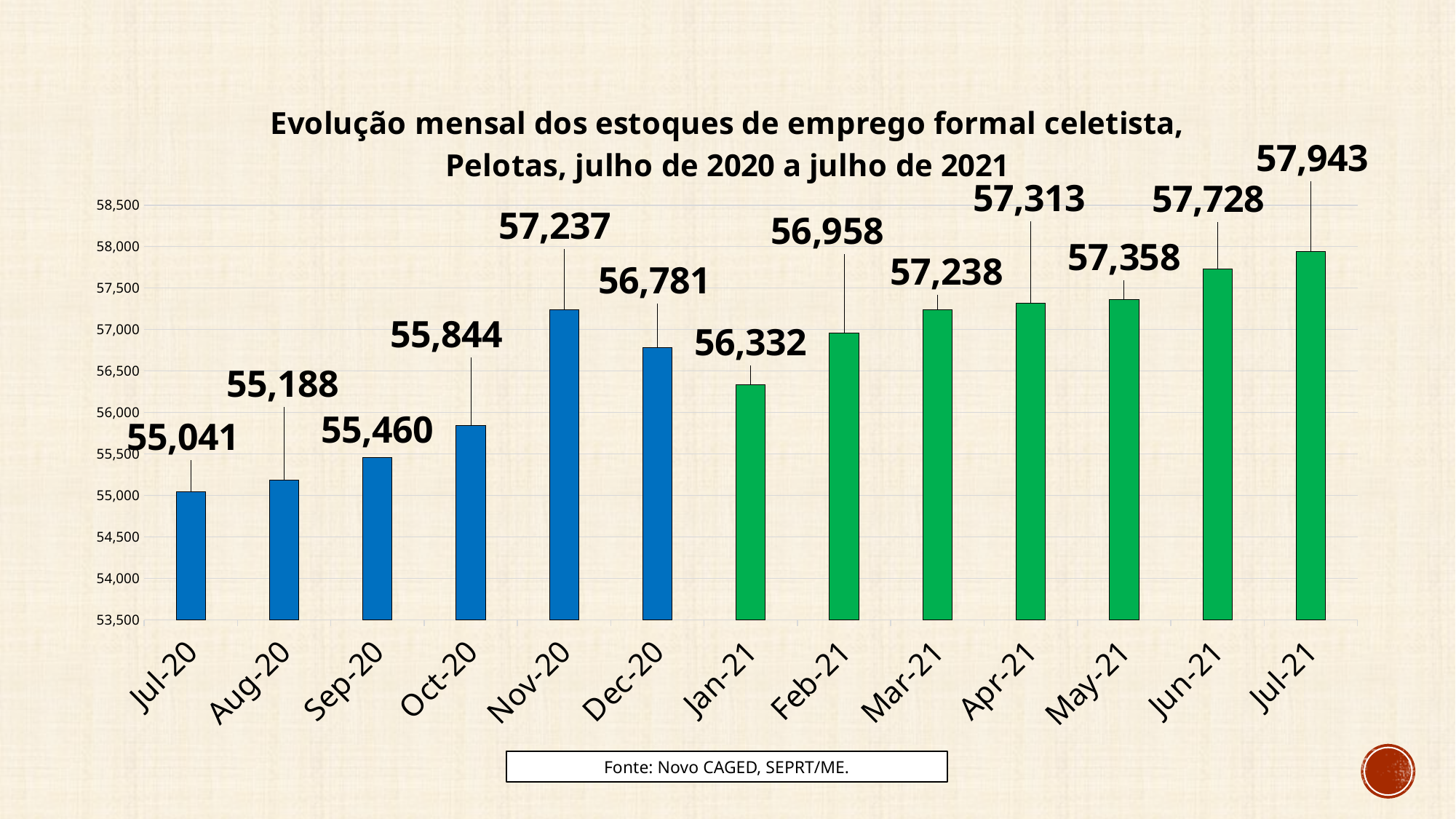
What source is cited below the chart? Novo CAGED, SEPRT/ME. Which month has the highest value? Jul-21 What is the value for Dec-20? 56,781 What is the difference between the values for Nov-20 and Dec-20? 456 Which month has the lowest value? Jul-20 Which is larger, the value for Feb-21 or the value for Dec-20? Feb-21 How many months are shown on the x axis? 13 What is the value for Jul-20? 55,041 Is the value for Oct-20 greater or less than 56,000? less What is the value for Apr-21? 57,313 What kind of chart is shown on the slide? bar chart What is the difference between the values for Jul-21 and Jul-20? 2,902